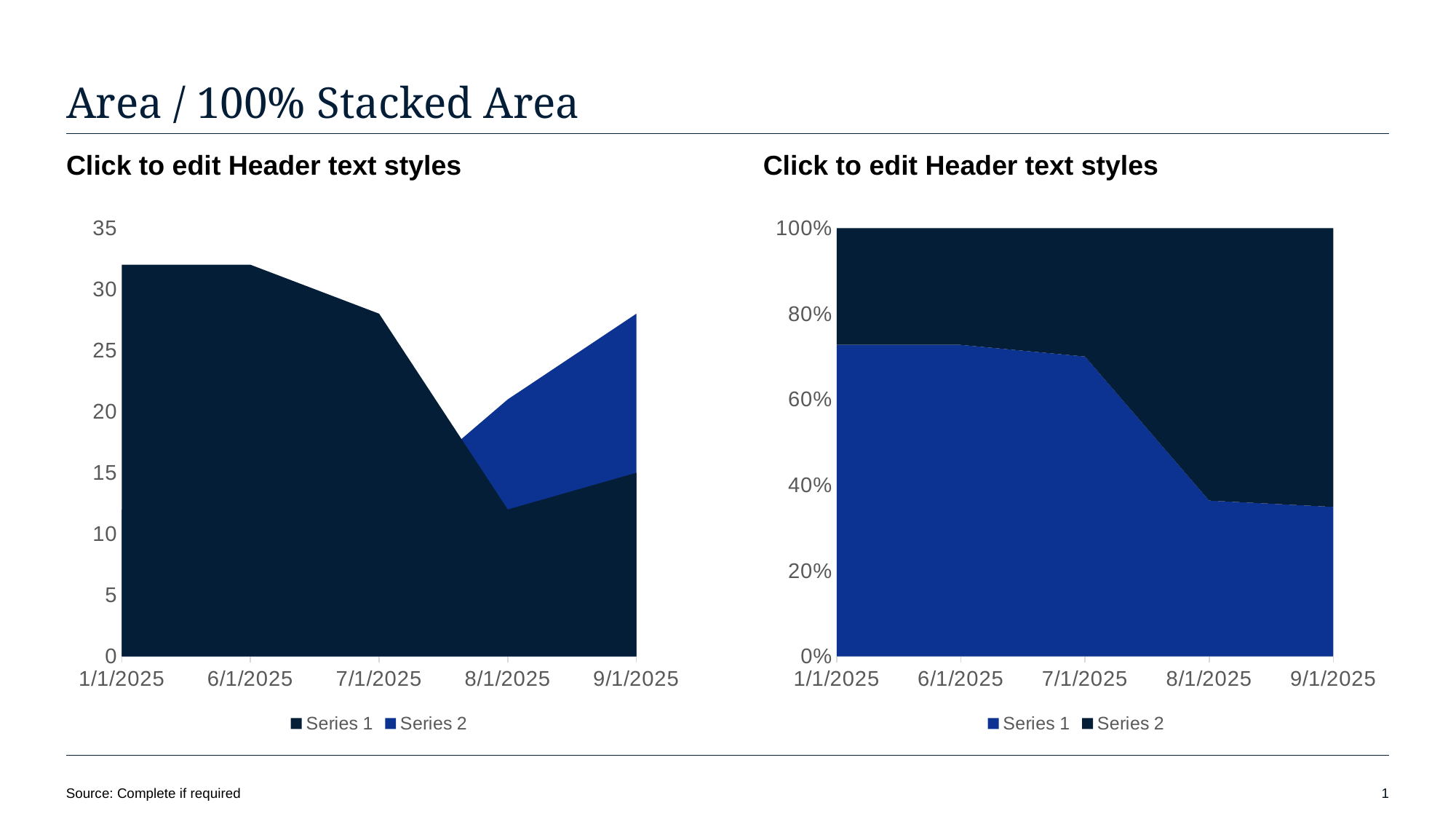
In the left chart, does Series 1 rise or fall between 7/1/2025 and 8/1/2025? fall What is the first date label on the x axis of the left chart? 1/1/2025 In the left chart, is the value for Series 1 at 8/1/2025 greater or less than 15? less What kind of chart is the chart on the left of the slide? area chart What kind of chart is the chart on the right of the slide? 100% stacked area chart How many series does the legend of the left chart list? 2 In the right chart, is the share for Series 1 at 9/1/2025 greater or less than 40%? less In the right chart, does the share of Series 1 rise or fall between 7/1/2025 and 8/1/2025? fall How many dates are shown on the x axis of the right chart? 5 In the left chart, is the value for Series 1 at 1/1/2025 greater or less than 30? greater